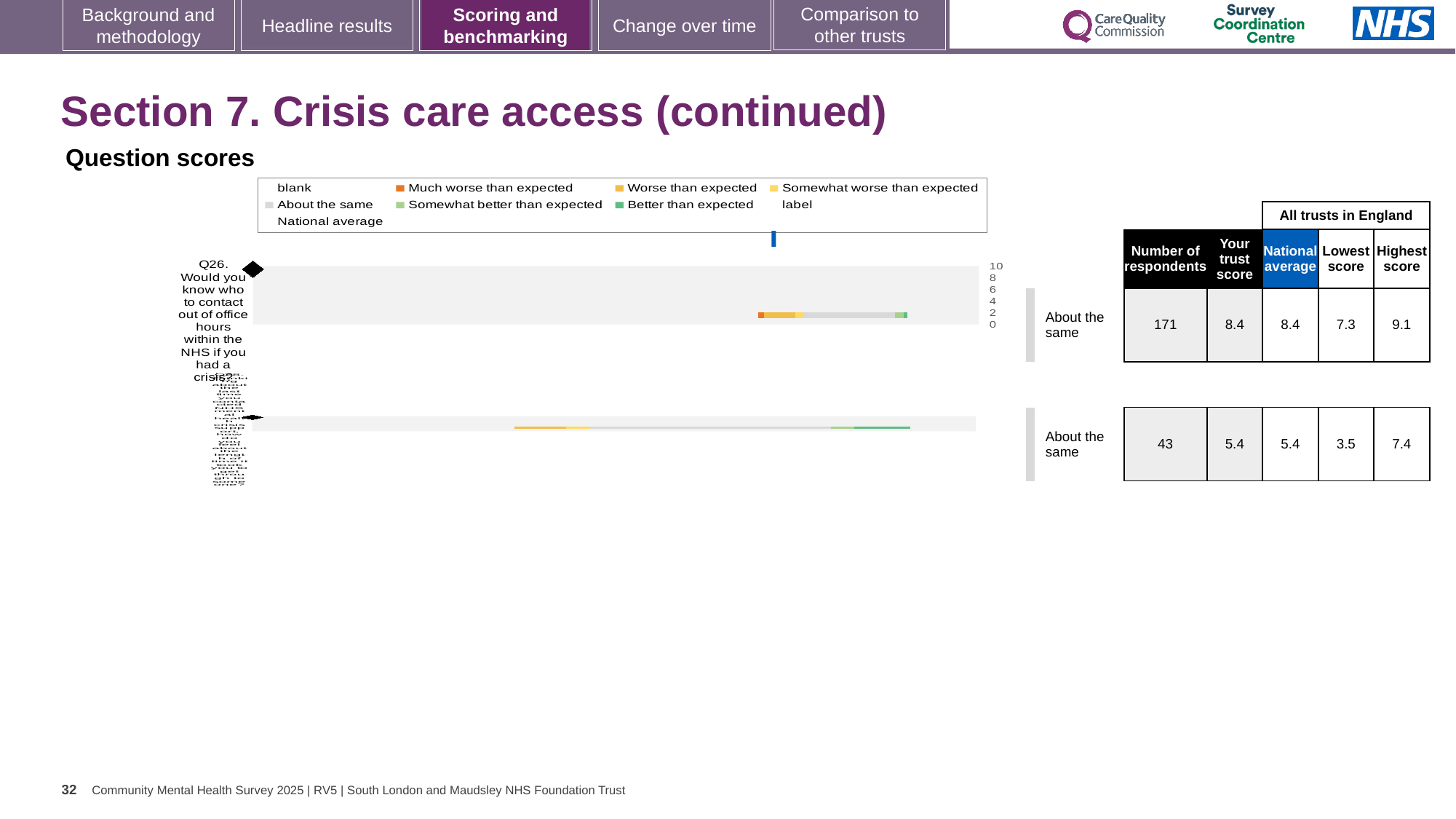
How many question rows (bars) are plotted in the chart? 2 Which colour does the legend use for 'Better than expected'? green What benchmark category is shown next to the bar for Q26 (Would you know who to contact out of office hours within the NHS if you had a crisis?)? About the same What kind of chart is shown under 'Question scores'? bar chart Which colour does the legend use for 'Much worse than expected'? orange What is the highest tick value shown on the chart's scale axis? 10